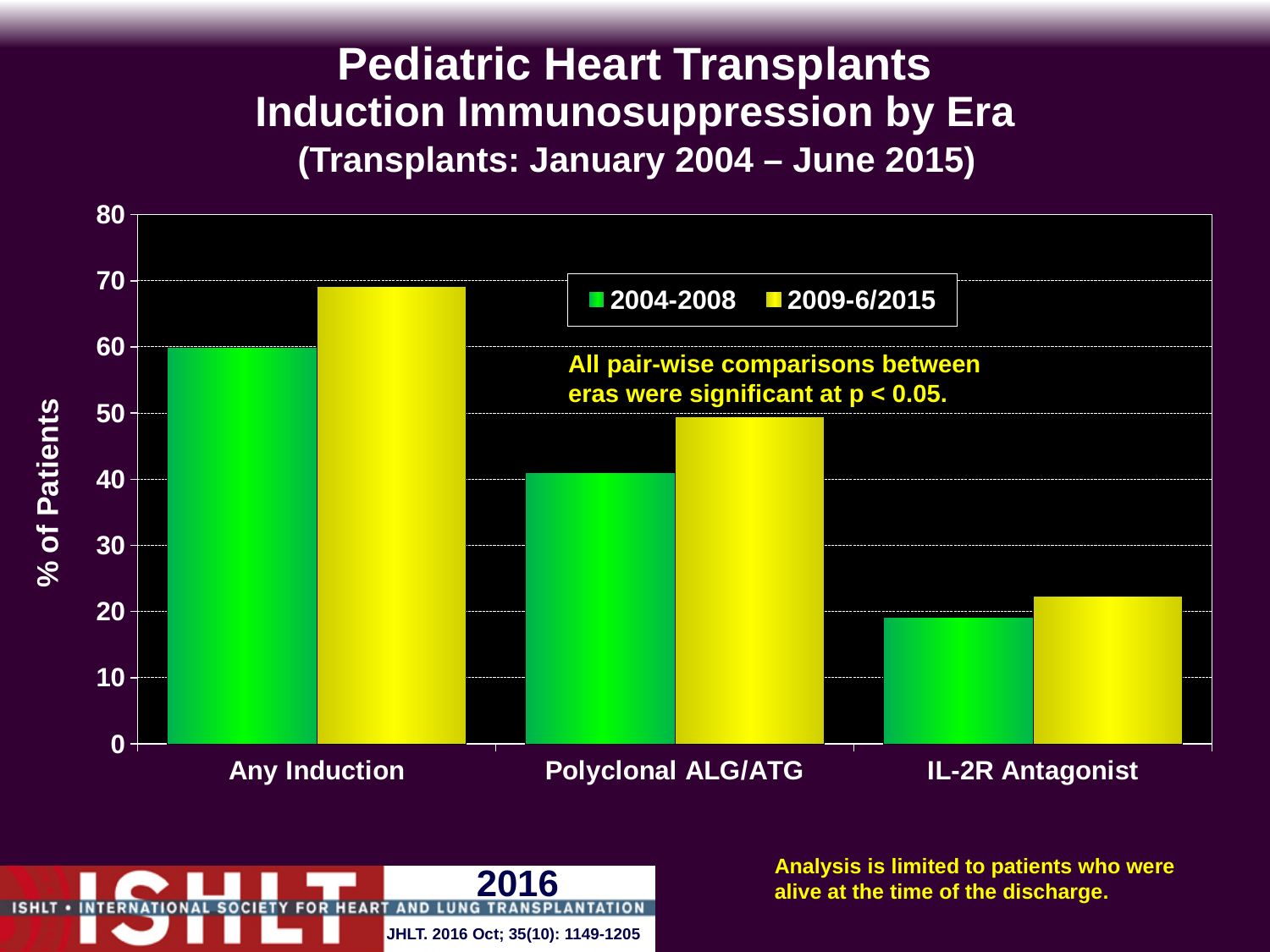
How many series does the legend list? 2 Which category has the lowest value for the 2004-2008 series? IL-2R Antagonist Do the values fall or rise moving from Any Induction to IL-2R Antagonist along the x axis? fall For Any Induction, which era has the larger value, 2004-2008 or 2009-6/2015? 2009-6/2015 Is the value for IL-2R Antagonist in 2009-6/2015 greater or less than 30? less Is the value for Any Induction in 2009-6/2015 greater or less than 60? greater Is the value for Polyclonal ALG/ATG in 2004-2008 greater or less than 50? less What is the label of the y axis? % of Patients What kind of chart is shown on the slide? bar chart For Polyclonal ALG/ATG, which era has the larger value, 2004-2008 or 2009-6/2015? 2009-6/2015 Which category has the highest value for the 2009-6/2015 series? Any Induction How many categories are shown on the x axis? 3